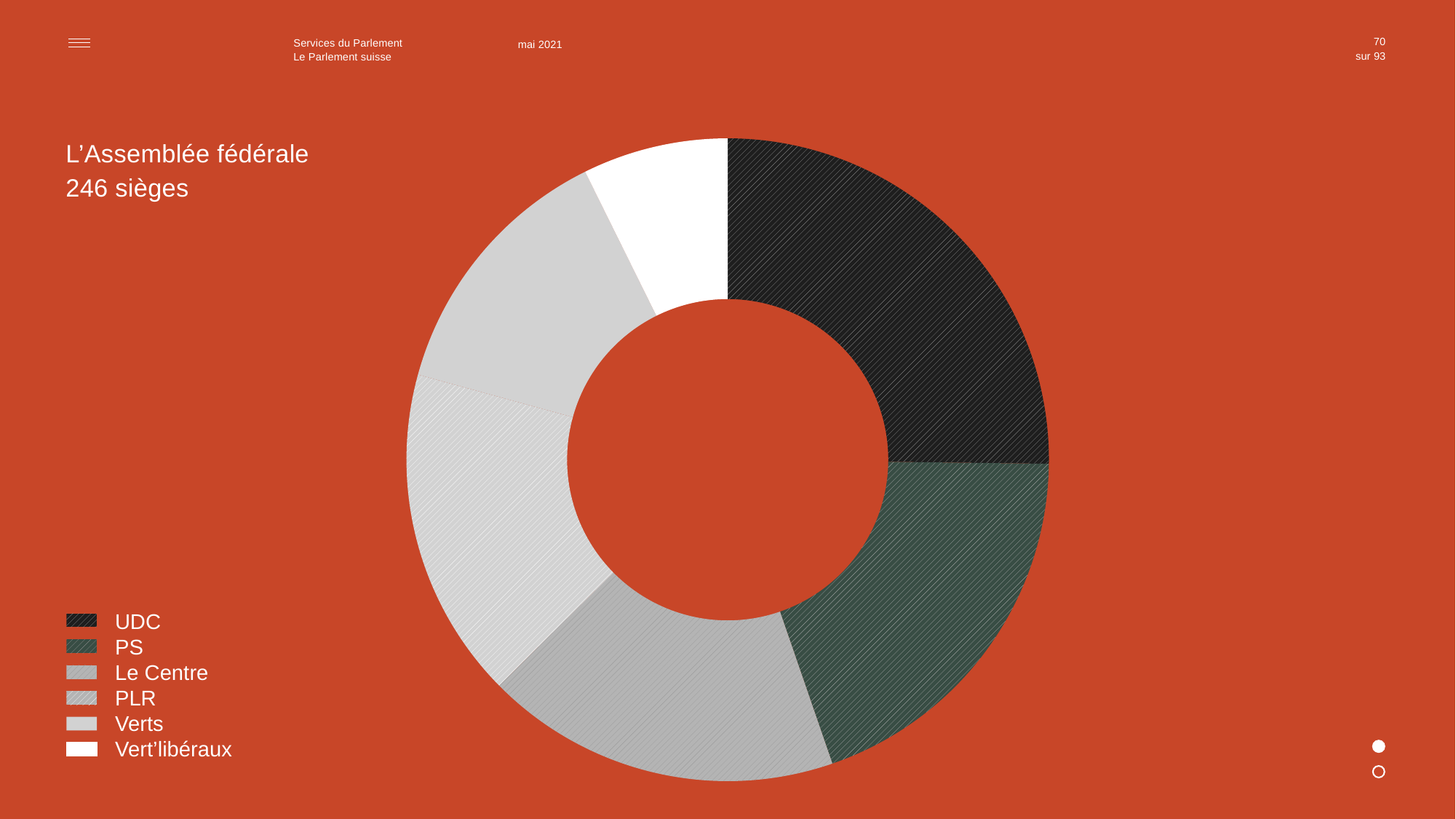
Which party has the smallest slice of the pie chart? Vert'libéraux Which slice is larger, UDC or Verts? UDC Which slice is larger, Verts or Vert'libéraux? Verts Which slice is larger, PS or Verts? PS How many seats in total does the chart title say the Assemblée fédérale has? 246 sièges How many entries does the legend list? 6 How many slices does the pie chart have? 6 What is the title of the chart? L'Assemblée fédérale 246 sièges Which party has the largest slice of the pie chart? UDC What kind of chart is shown on the slide? Doughnut chart